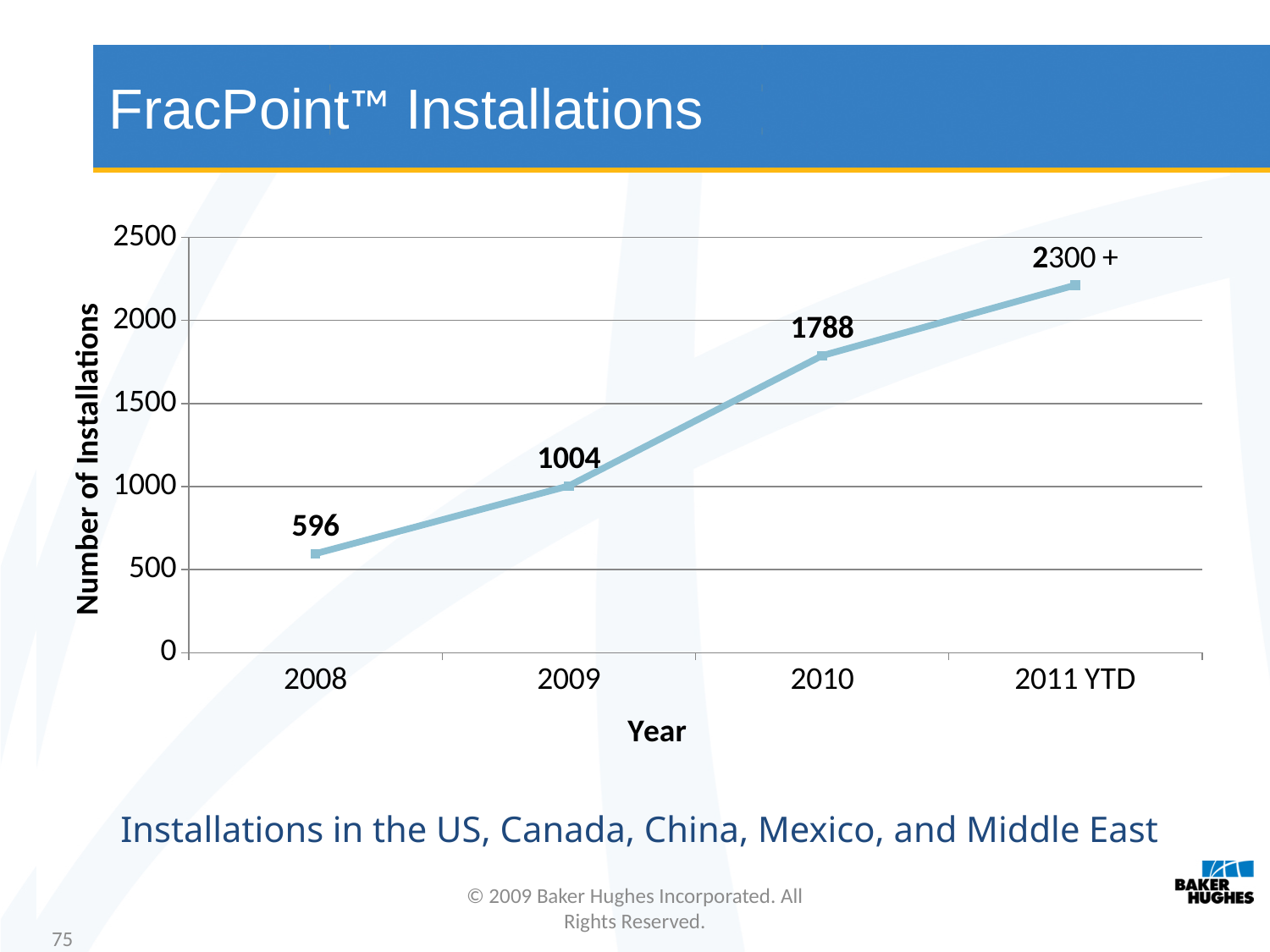
Is the value for 2010 greater or less than 1500? greater What type of chart is shown on the slide? line chart What is the number of installations for 2009? 1004 Which year has the highest number of installations? 2011 YTD How many years are plotted on the chart? 4 What is the number of installations for 2008? 596 Which year has more installations, 2009 or 2010? 2010 What is the number of installations for 2010? 1788 What is the difference in installations between 2009 and 2008? 408 What label is shown for the 2011 YTD data point? 2300 + What is the difference in installations between 2010 and 2009? 784 Which year has the lowest number of installations? 2008